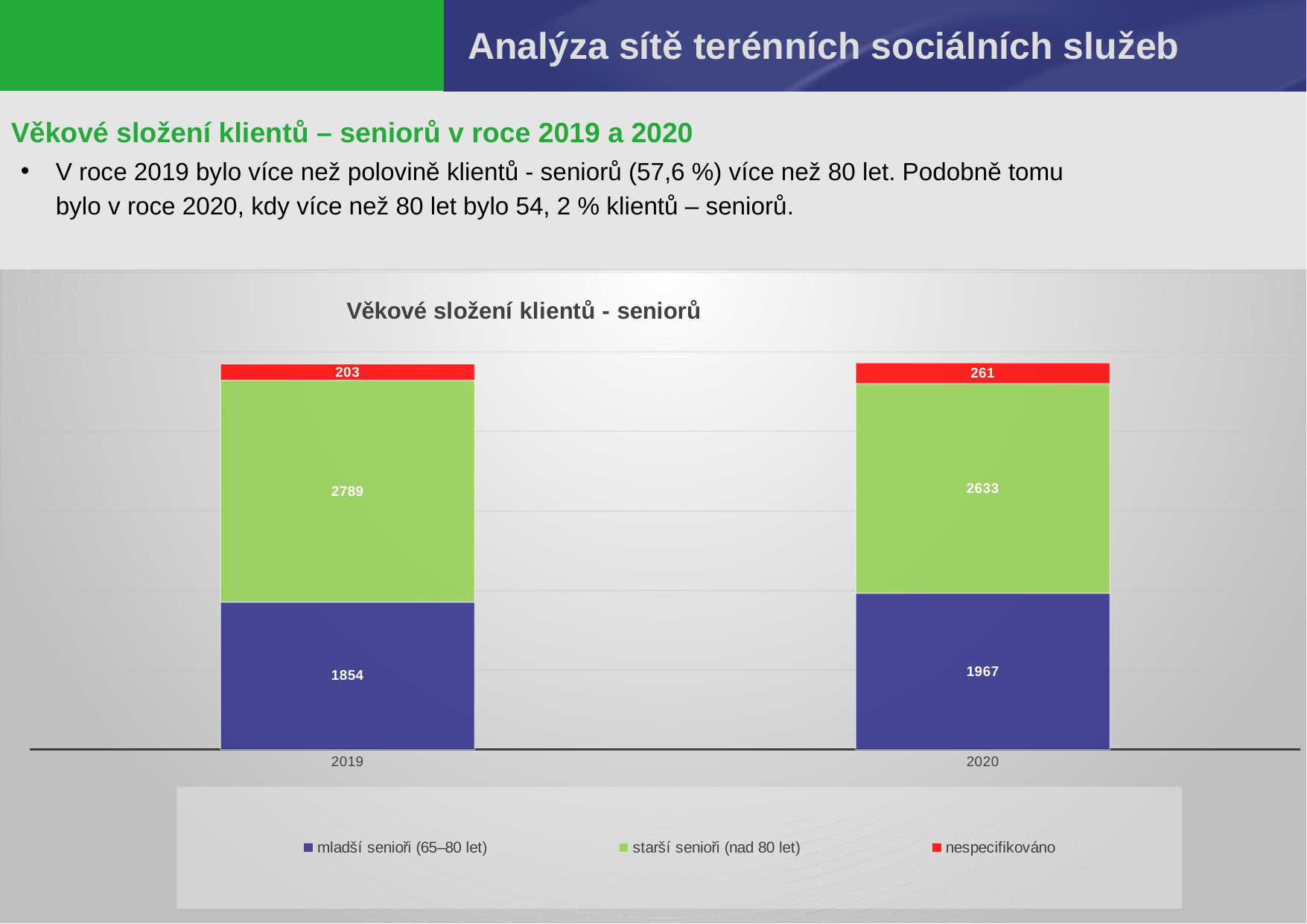
How many series does the legend list? 3 How many categories are shown on the x axis? 2 What is the value for 'nespecifikováno' in 2020? 261 What is the total of the stacked bar for 2019? 4846 What is the total of the stacked bar for 2020? 4861 What kind of chart is shown on the slide? Stacked bar chart What is the value for 'nespecifikováno' in 2019? 203 Which series has the lowest value in 2020? nespecifikováno What is the difference between the 'starší senioři (nad 80 let)' values for 2019 and 2020? 156 What is the value for 'mladší senioři (65–80 let)' in 2020? 1967 Which year has the larger value for 'mladší senioři (65–80 let)', 2019 or 2020? 2020 What is the value for 'starší senioři (nad 80 let)' in 2019? 2789